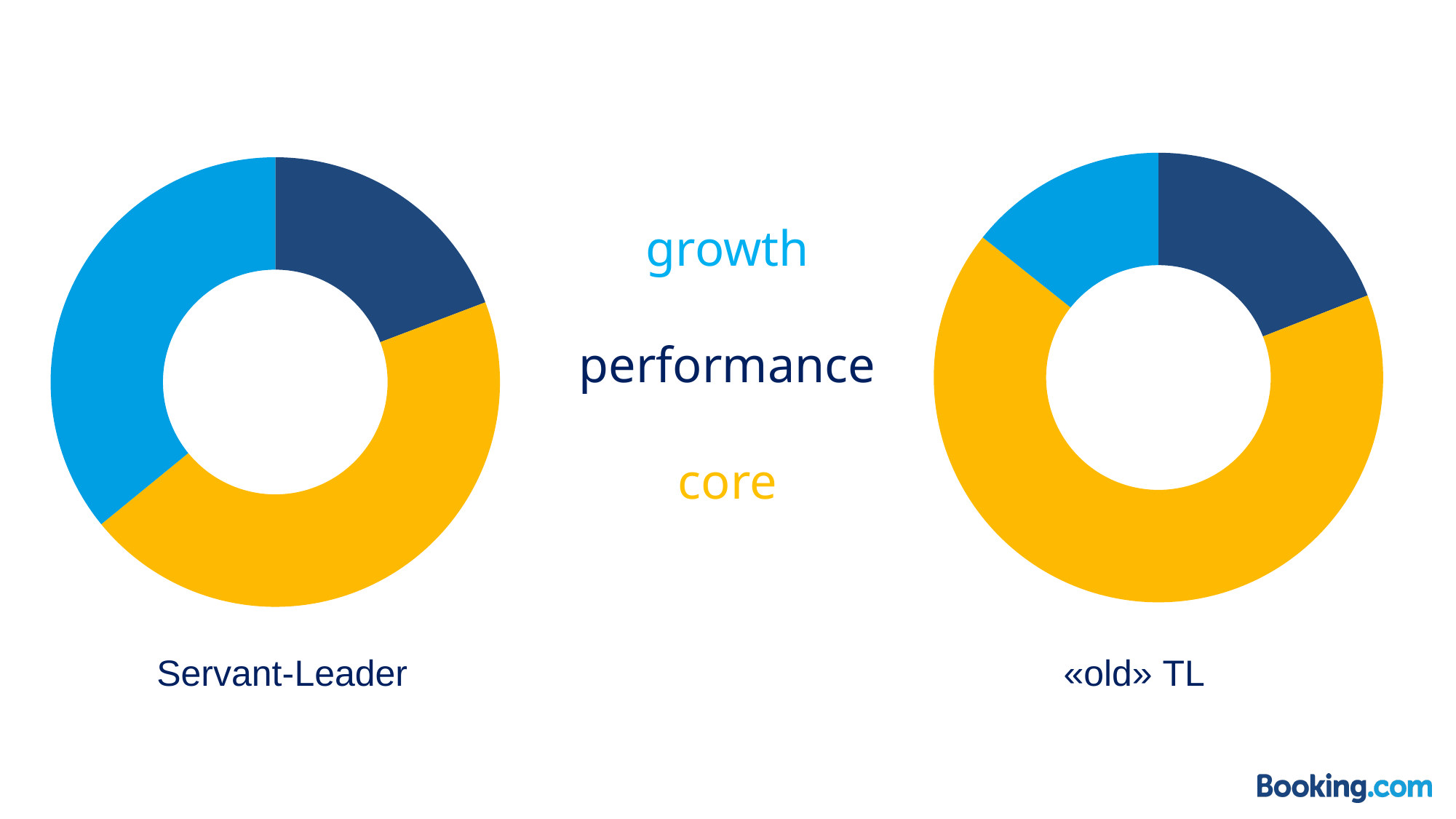
Which chart has the larger growth slice: Servant-Leader or «old» TL? Servant-Leader In the Servant-Leader chart, which category has the smallest slice? performance In the Servant-Leader chart, which category has the largest slice? core In the Servant-Leader chart, which slice is larger: growth or performance? growth What colour represents the core category in both charts? yellow In the «old» TL chart, which category has the largest slice? core How many categories does the legend in the middle of the slide list? 3 In the «old» TL chart, which category has the smallest slice? growth What is the label under the left chart? Servant-Leader In the «old» TL chart, which slice is larger: growth or performance? performance What kind of chart is used for the Servant-Leader chart? pie chart (donut) How many slices does the «old» TL chart have? 3